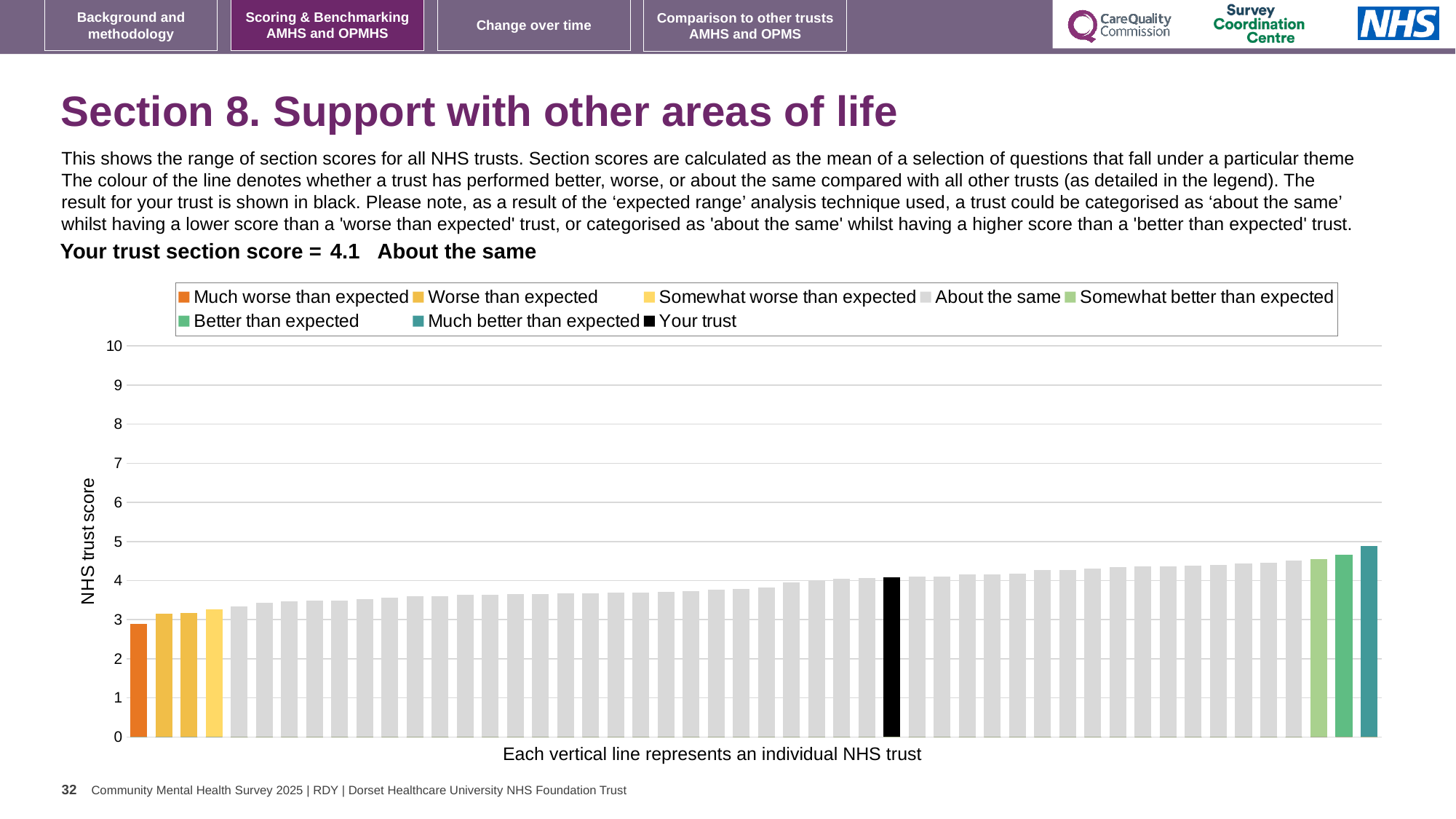
What is the label on the y axis? NHS trust score Is the value for your trust greater or less than 4? greater How is your trust categorised compared with other trusts? About the same Is the value of the highest bar greater or less than 4? greater What is the section score for your trust? 4.1 What kind of chart is shown on the slide? Bar chart What colour is the bar representing your trust? Black How many entries does the legend list? 8 Which legend category does the highest bar belong to? Much better than expected Do the bar values rise or fall from left to right along the x axis? Rise Which legend category does the lowest bar belong to? Much worse than expected Is the value of the lowest bar greater or less than 4? less